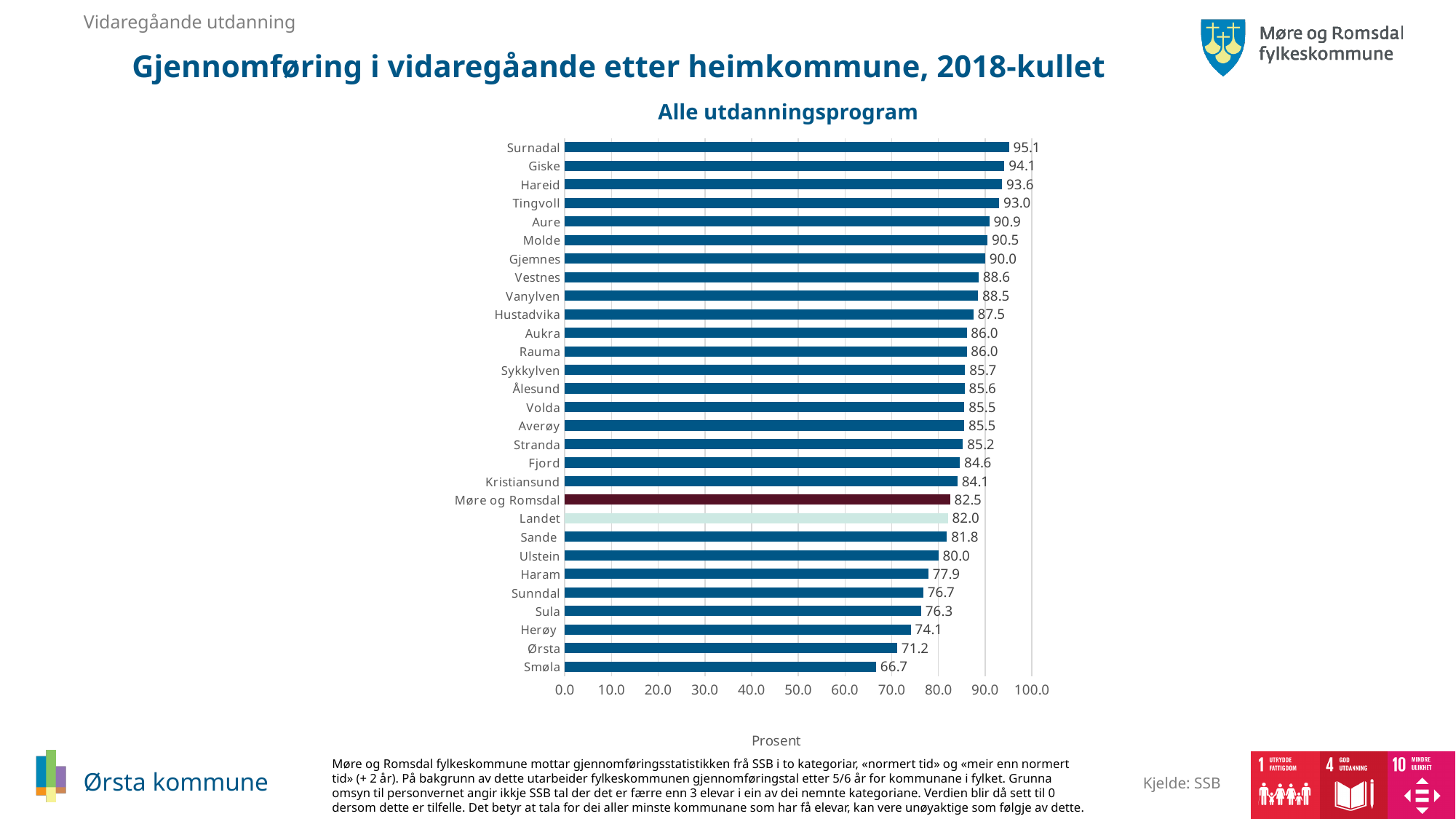
Which is larger, the value for Volda or the value for Herøy? Volda What is the value for Ørsta? 71.2 What is the difference between the values for Surnadal and Smøla? 28.4 How many categories are shown in the chart? 29 Which category has the lowest value? Smøla What is the value for Møre og Romsdal? 82.5 What is the value for Landet? 82.0 Which category has the highest value? Surnadal What is the difference between the values for Møre og Romsdal and Ørsta? 11.3 What kind of chart is shown on the slide? bar chart What is the title of the chart? Alle utdanningsprogram Is the value for Molde greater or less than 90.0? greater